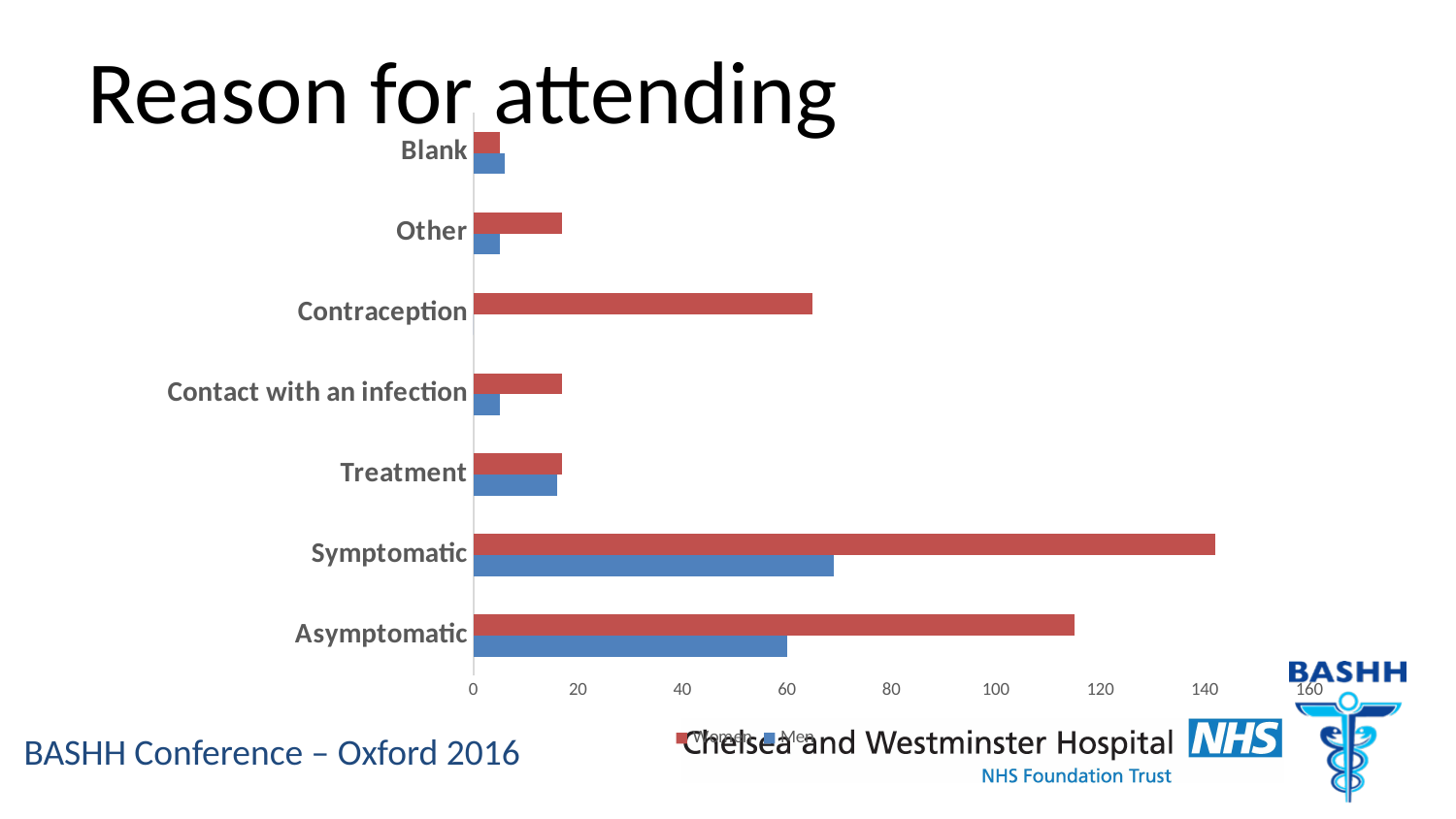
Which category has the lowest value for Women? Blank Is the value for Women in the Asymptomatic category greater or less than 100? greater What colour are the bars for the Women series? red For Symptomatic, which is larger: the value for Women or the value for Men? Women Is the value for Men in the Symptomatic category greater or less than 80? less Which category has the highest value for Women? Symptomatic How many categories (reasons for attending) are shown on the chart? 7 Which category has the highest value for Men? Symptomatic What kind of chart is shown on the slide? bar chart How many series does the chart's legend list? 2 Which category has no bar for Men? Contraception For Men, which is larger: Symptomatic or Asymptomatic? Symptomatic